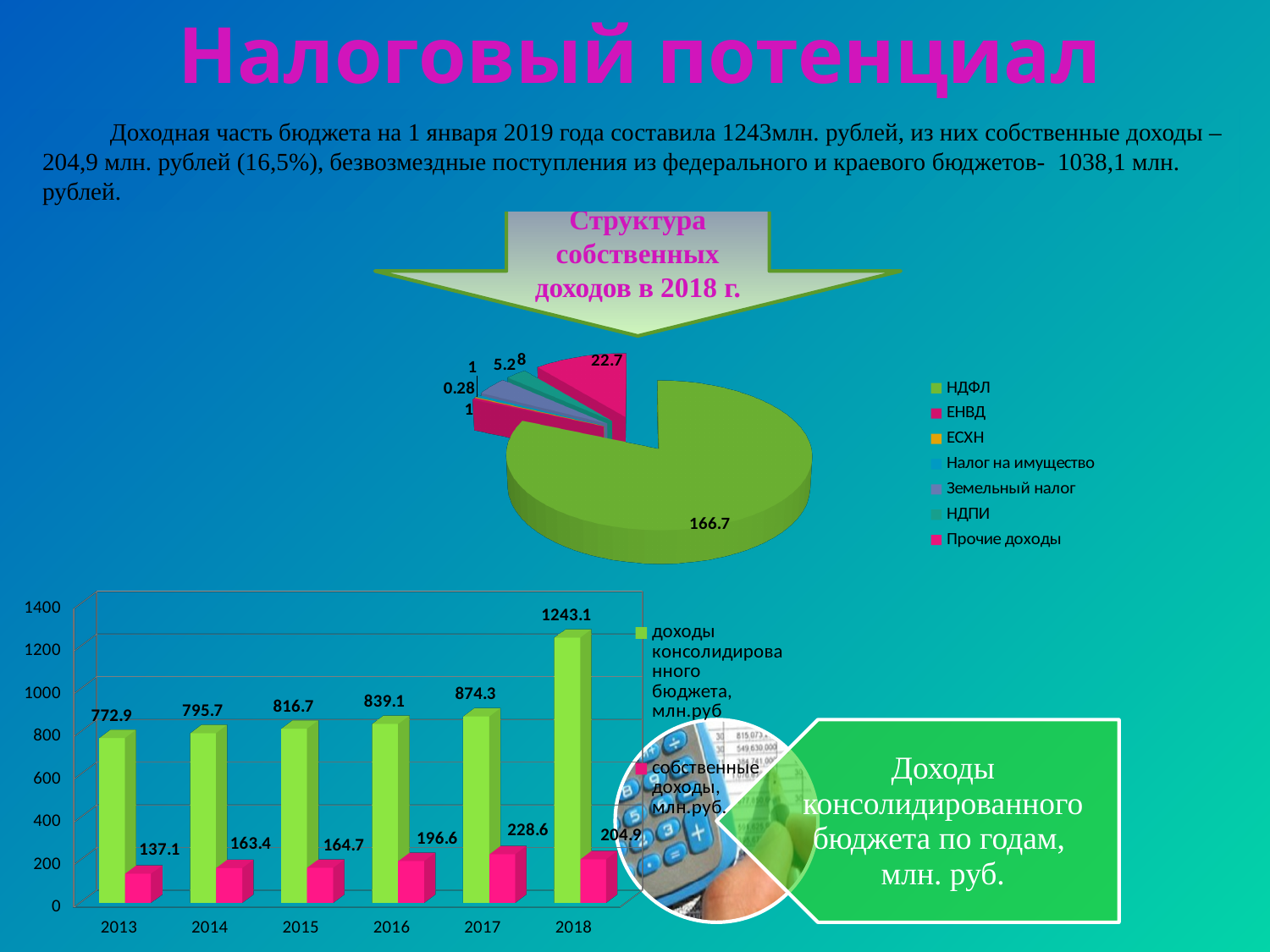
In the pie chart 'Структура собственных доходов в 2018 г.', what is the value for ЕНВД? 1 In the bar chart 'Доходы консолидированного бюджета по годам', what is the value of доходы консолидированного бюджета for 2018? 1243.1 In the bar chart 'Доходы консолидированного бюджета по годам', which year has the lowest value of собственные доходы? 2013 In the pie chart 'Структура собственных доходов в 2018 г.', what is the value for НДФЛ? 166.7 In the bar chart 'Доходы консолидированного бюджета по годам', do the values of доходы консолидированного бюджета rise or fall from 2013 to 2018? rise In the bar chart 'Доходы консолидированного бюджета по годам', how many years are shown on the x axis? 6 In the bar chart 'Доходы консолидированного бюджета по годам', is собственные доходы larger in 2017 or in 2018? 2017 In the bar chart 'Доходы консолидированного бюджета по годам', which year has the highest value of доходы консолидированного бюджета? 2018 In the bar chart 'Доходы консолидированного бюджета по годам', what is the difference between доходы консолидированного бюджета in 2018 and in 2017? 368.8 In the bar chart 'Доходы консолидированного бюджета по годам', how many series does the legend list? 2 In the pie chart 'Структура собственных доходов в 2018 г.', how many categories does the legend list? 7 In the bar chart 'Доходы консолидированного бюджета по годам', what is the value of собственные доходы for 2017? 228.6